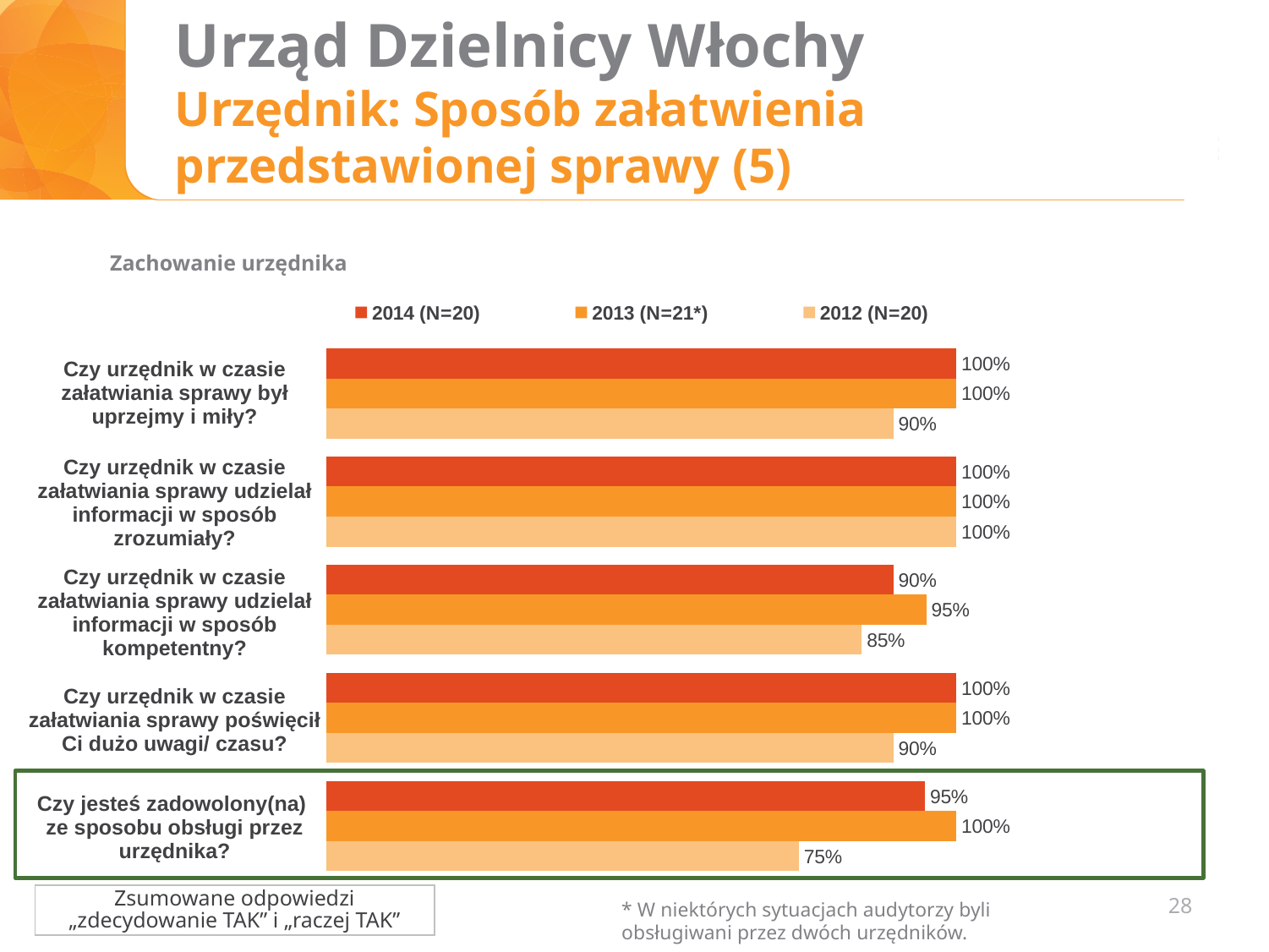
What is the 2012 (N=20) value for "Czy urzędnik w czasie załatwiania sprawy poświęcił Ci dużo uwagi/ czasu?"? 90% Which year has the lowest value for "Czy jesteś zadowolony(na) ze sposobu obsługi przez urzędnika?"? 2012 (N=20) What is the 2014 (N=20) value for "Czy jesteś zadowolony(na) ze sposobu obsługi przez urzędnika?"? 95% What kind of chart is shown on the slide? bar chart What is the 2013 (N=21*) value for "Czy urzędnik w czasie załatwiania sprawy udzielał informacji w sposób kompetentny?"? 95% How many question categories are plotted on the chart? 5 How many series does the legend list? 3 Which year has the highest value for "Czy urzędnik w czasie załatwiania sprawy udzielał informacji w sposób kompetentny?"? 2013 (N=21*) For "Czy urzędnik w czasie załatwiania sprawy udzielał informacji w sposób kompetentny?", which is larger: the 2014 (N=20) value or the 2012 (N=20) value? 2014 (N=20) What is the difference between the 2013 (N=21*) and 2012 (N=20) values for "Czy jesteś zadowolony(na) ze sposobu obsługi przez urzędnika?"? 25% What is the 2012 (N=20) value for "Czy urzędnik w czasie załatwiania sprawy był uprzejmy i miły?"? 90% What is the title shown above the chart? Zachowanie urzędnika